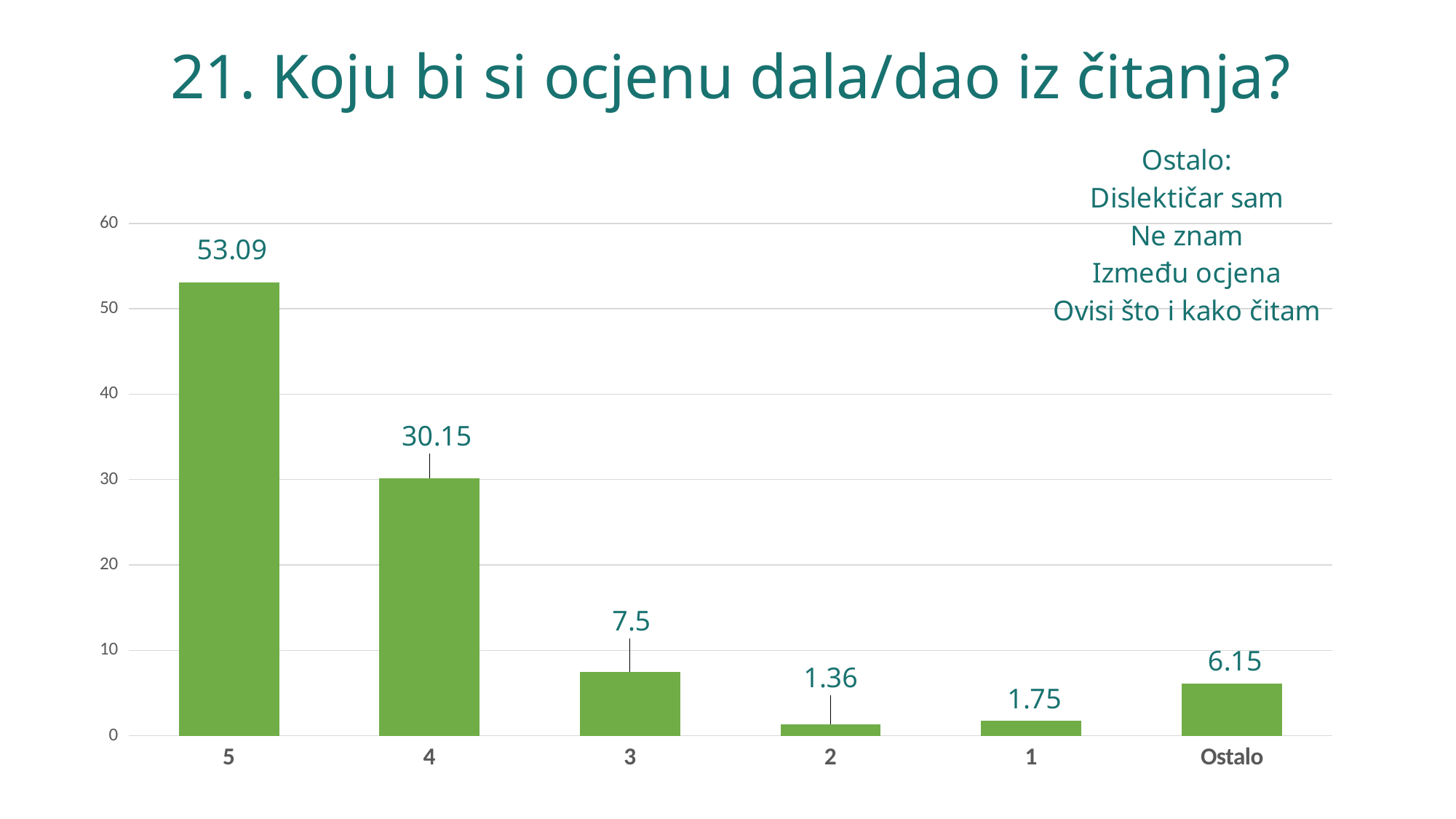
What is the title of the slide? 21. Koju bi si ocjenu dala/dao iz čitanja? What is the value for category 3? 7.5 What kind of chart is shown on the slide? bar chart Which is larger, the value for category 1 or the value for category 2? 1 Is the value for category 4 greater or less than 40? less What is the value for the Ostalo category? 6.15 Which category has the highest value? 5 Which category has the lowest value? 2 What is the value for category 5? 53.09 What is the value for category 4? 30.15 How many categories are shown on the x axis? 6 What is the difference between the values for category 5 and category 4? 22.94